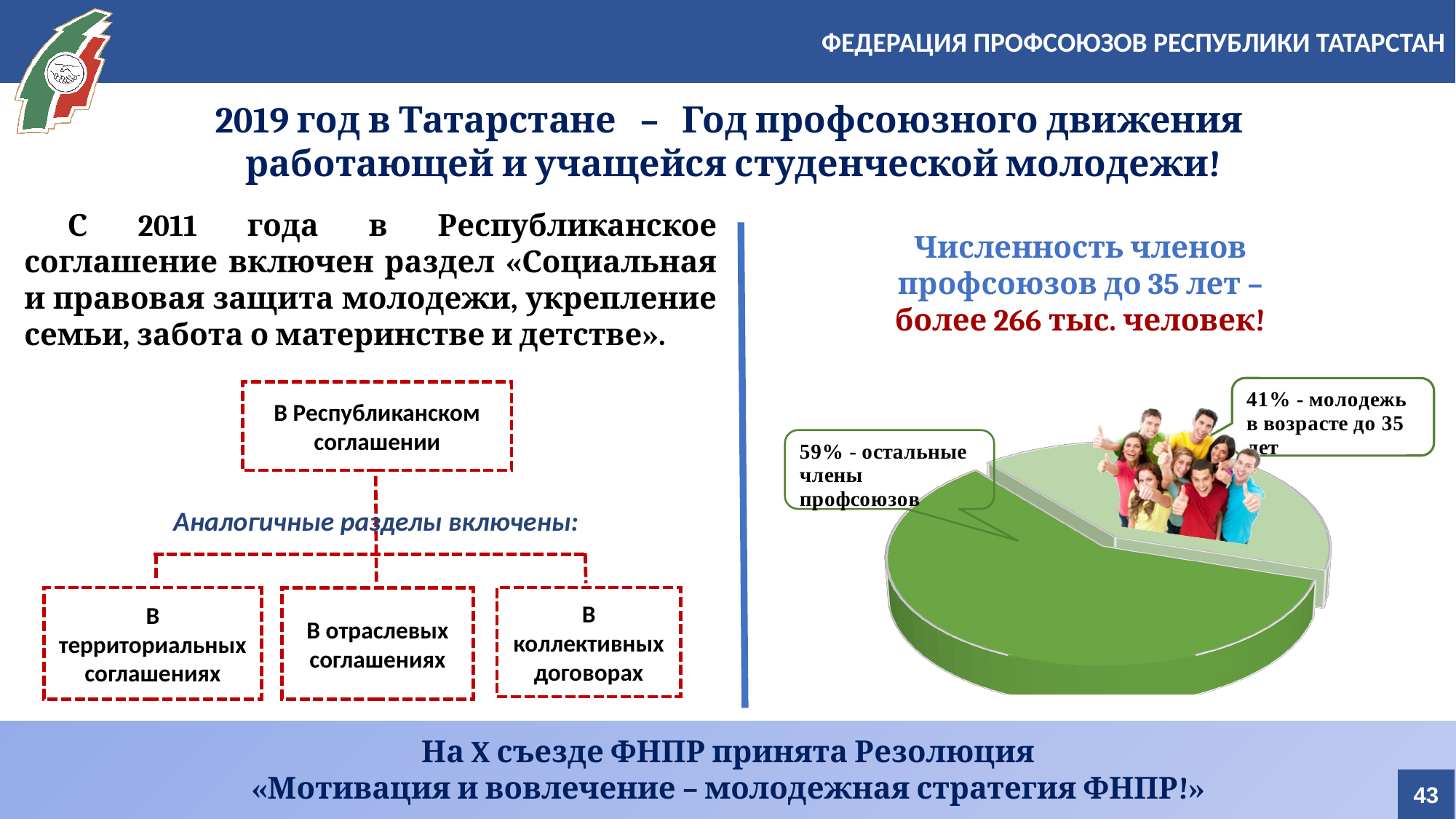
Which slice of the pie chart is the smallest? молодежь в возрасте до 35 лет Is the share of youth under 35 in the pie chart greater or less than 50%? less Which slice of the pie chart is the largest? остальные члены профсоюзов What kind of chart is shown on the right side of the slide? pie chart According to the heading above the pie chart, how many union members are under 35? более 266 тыс. человек How many slices does the pie chart have? 2 What is the total of the two slices shown in the pie chart? 100% By how many percentage points does the "остальные члены профсоюзов" slice exceed the "молодежь в возрасте до 35 лет" slice? 18 What share of the pie chart is labelled "молодежь в возрасте до 35 лет"? 41% Which is larger in the pie chart: the share of youth under 35 or the share of other union members? other union members (остальные члены профсоюзов) What colour is the pie chart's largest slice? green What share of the pie chart is labelled "остальные члены профсоюзов"? 59%